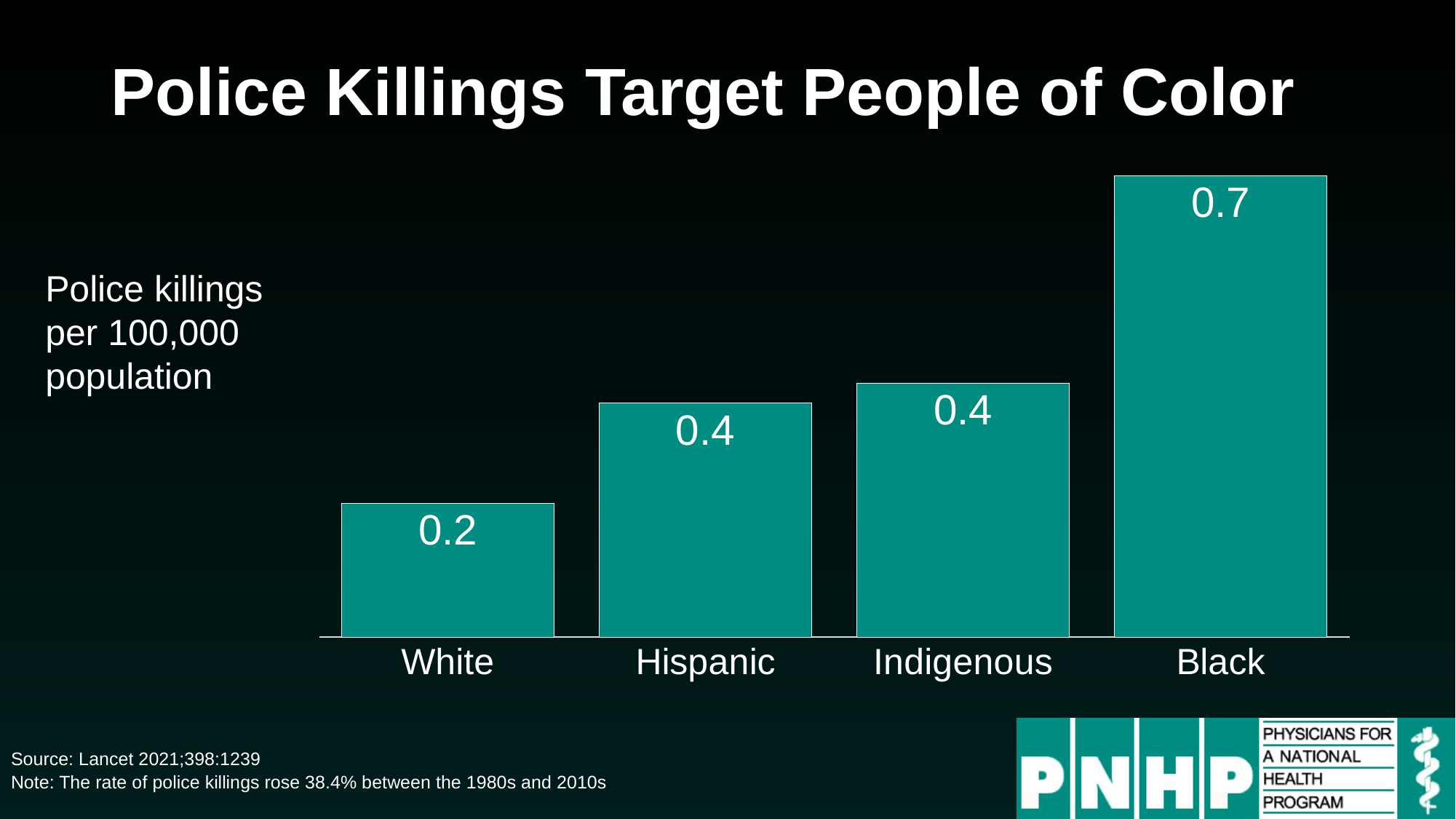
Which group has the lowest rate of police killings per 100,000 population? White What kind of chart is shown on the slide? Bar chart Which is larger, the police killing rate for Black people or for Hispanic people? Black What is the rate of police killings per 100,000 population for White people? 0.2 What is the difference between the police killing rates for Black and White people? 0.5 Which group has the highest rate of police killings per 100,000 population? Black What is the rate of police killings per 100,000 population for Black people? 0.7 What is the rate of police killings per 100,000 population for Indigenous people? 0.4 What is the rate of police killings per 100,000 population for Hispanic people? 0.4 What is the title of the slide containing the chart? Police Killings Target People of Color What is the difference between the police killing rates for Hispanic and White people? 0.2 How many groups are shown in the chart? 4